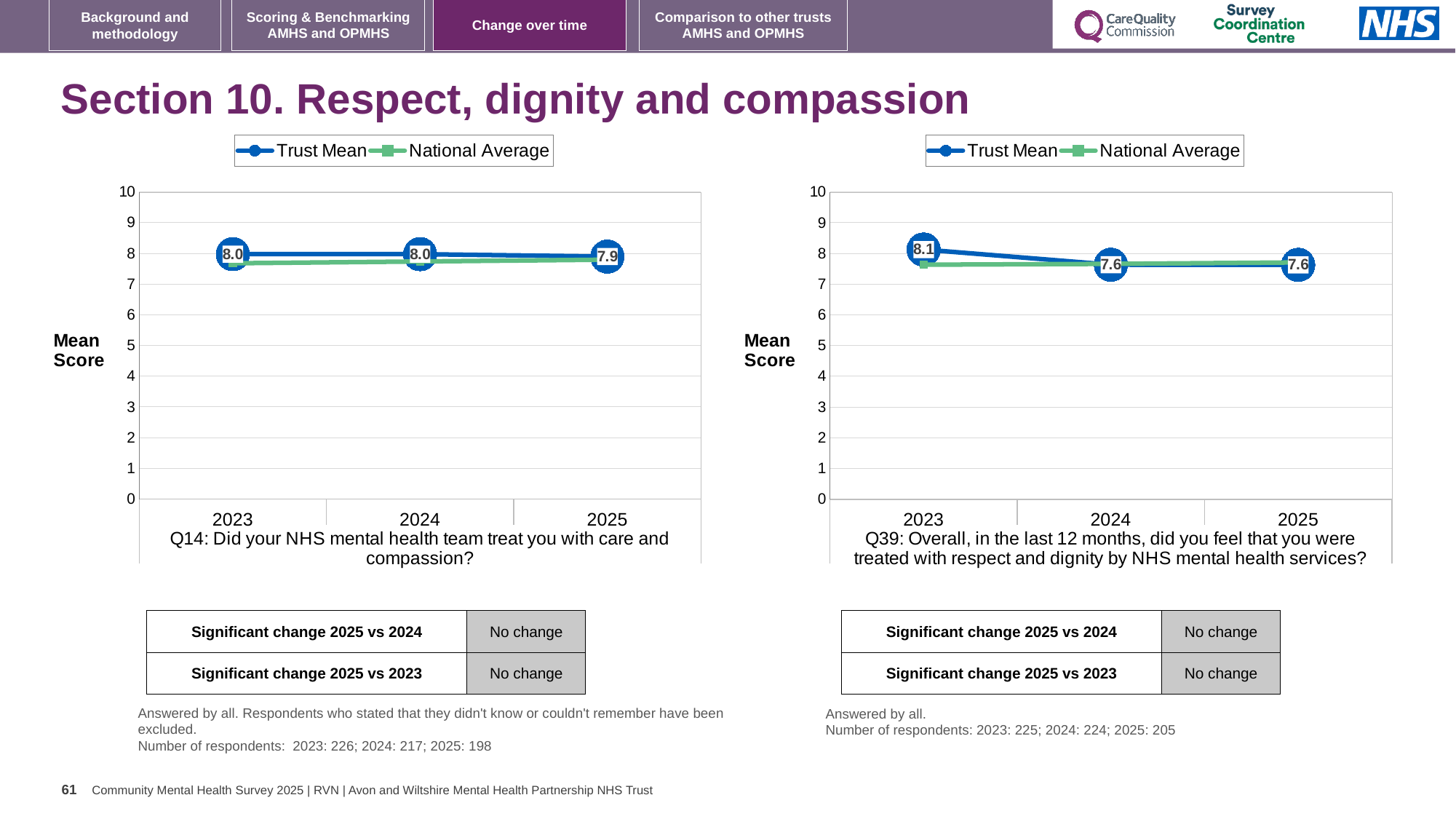
On the Q14 chart (left), what is the Trust Mean score for 2025? 7.9 On the Q14 chart (left), how many years are shown on the x axis? 3 On the Q39 chart (right), is the Trust Mean for 2023 greater or less than 8? greater On the Q39 chart (right), what is the Trust Mean score for 2023? 8.1 On the Q39 chart (right), what is the Trust Mean score for 2024? 7.6 On the Q39 chart (right), how many series does the legend list? 2 On the Q39 chart (right), does the Trust Mean rise or fall from 2023 to 2024? Fall On the Q14 chart (left), what is the Trust Mean score for 2023? 8.0 On the Q39 chart (right), in which year is the Trust Mean highest? 2023 What type of chart is used on the Q14 chart (left)? Line chart On the Q39 chart (right), what is the difference between the Trust Mean in 2023 and in 2025? 0.5 On the Q14 chart (left), what is the difference between the Trust Mean in 2023 and in 2025? 0.1